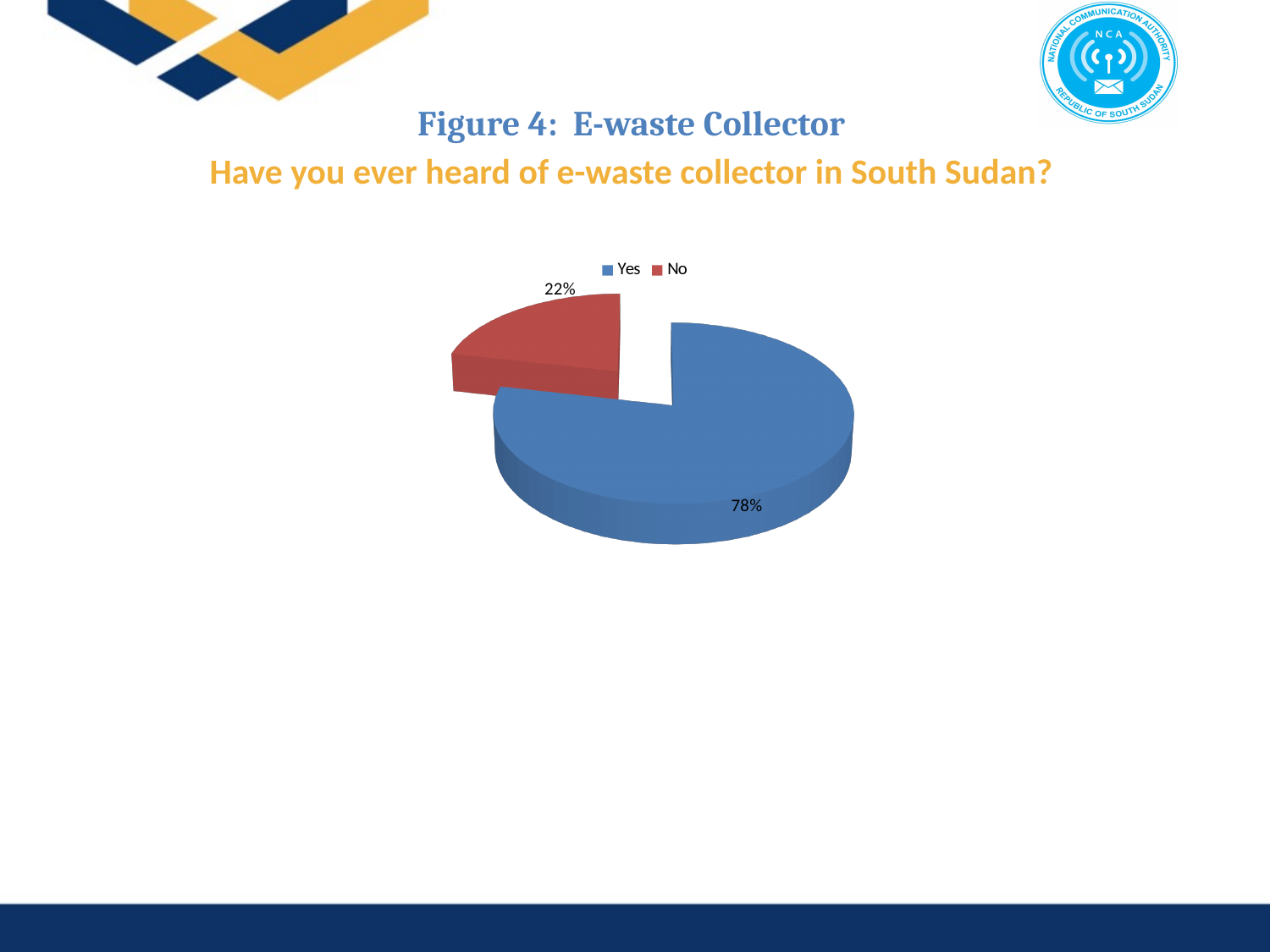
How many entries does the legend list? 2 What question does the chart answer, according to the slide subtitle? Have you ever heard of e-waste collector in South Sudan? Which response has the smallest share of the pie? No What share of the pie does the No slice represent? 22% What percentage of respondents answered No? 22% What percentage of respondents answered Yes? 78% How many slices does the pie chart have? 2 What kind of chart is shown on the slide? pie chart Which is larger, the share for Yes or the share for No? Yes What is the difference in percentage points between the Yes and No shares? 56 Which response has the largest share of the pie? Yes What colour is the Yes slice? blue